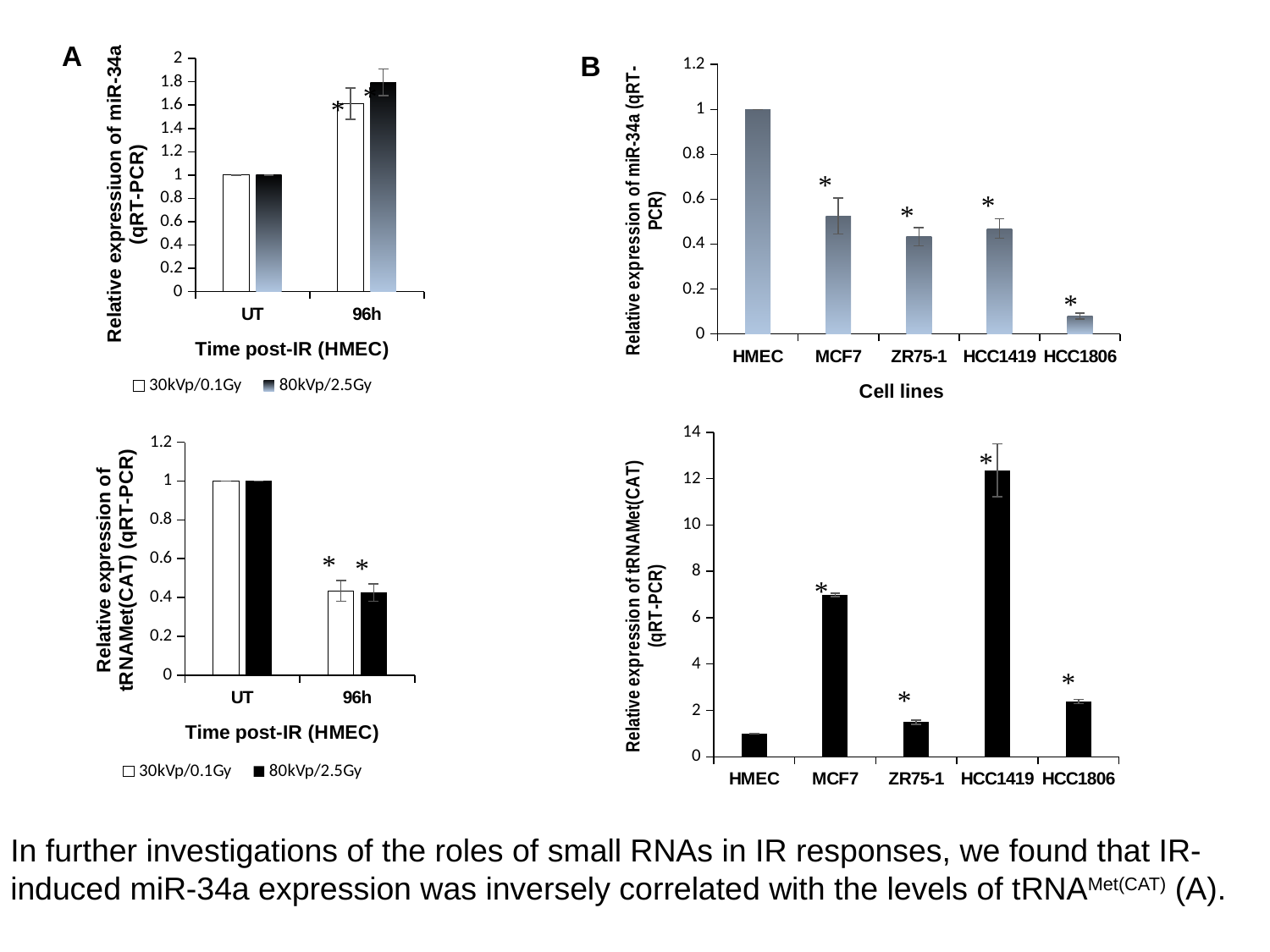
In the top-right chart of miR-34a expression across cell lines, which cell line has the highest value? HMEC What kind of chart is the bottom-left chart of tRNAMet(CAT) expression versus time post-IR? bar chart In the top-right chart of miR-34a expression across cell lines, how many cell lines are shown on the x axis? 5 In the bottom-left chart of tRNAMet(CAT) expression versus time post-IR, is the 30kVp/0.1Gy value at 96h greater or less than 0.6? less In the bottom-right chart of tRNAMet(CAT) expression across cell lines, is the value for MCF7 greater or less than 6? greater In the top-left chart of miR-34a expression versus time post-IR, how many series does the legend list? 2 In the top-right chart of miR-34a expression across cell lines, which cell line has the lowest value? HCC1806 In the top-left chart of miR-34a expression versus time post-IR, is the 80kVp/2.5Gy value at 96h greater or less than 1.4? greater In the bottom-right chart of tRNAMet(CAT) expression across cell lines, which cell line has the highest value? HCC1419 In the bottom-right chart of tRNAMet(CAT) expression across cell lines, which is larger, the value for ZR75-1 or the value for HCC1806? HCC1806 In the top-right chart of miR-34a expression across cell lines, what is the value for HMEC? 1